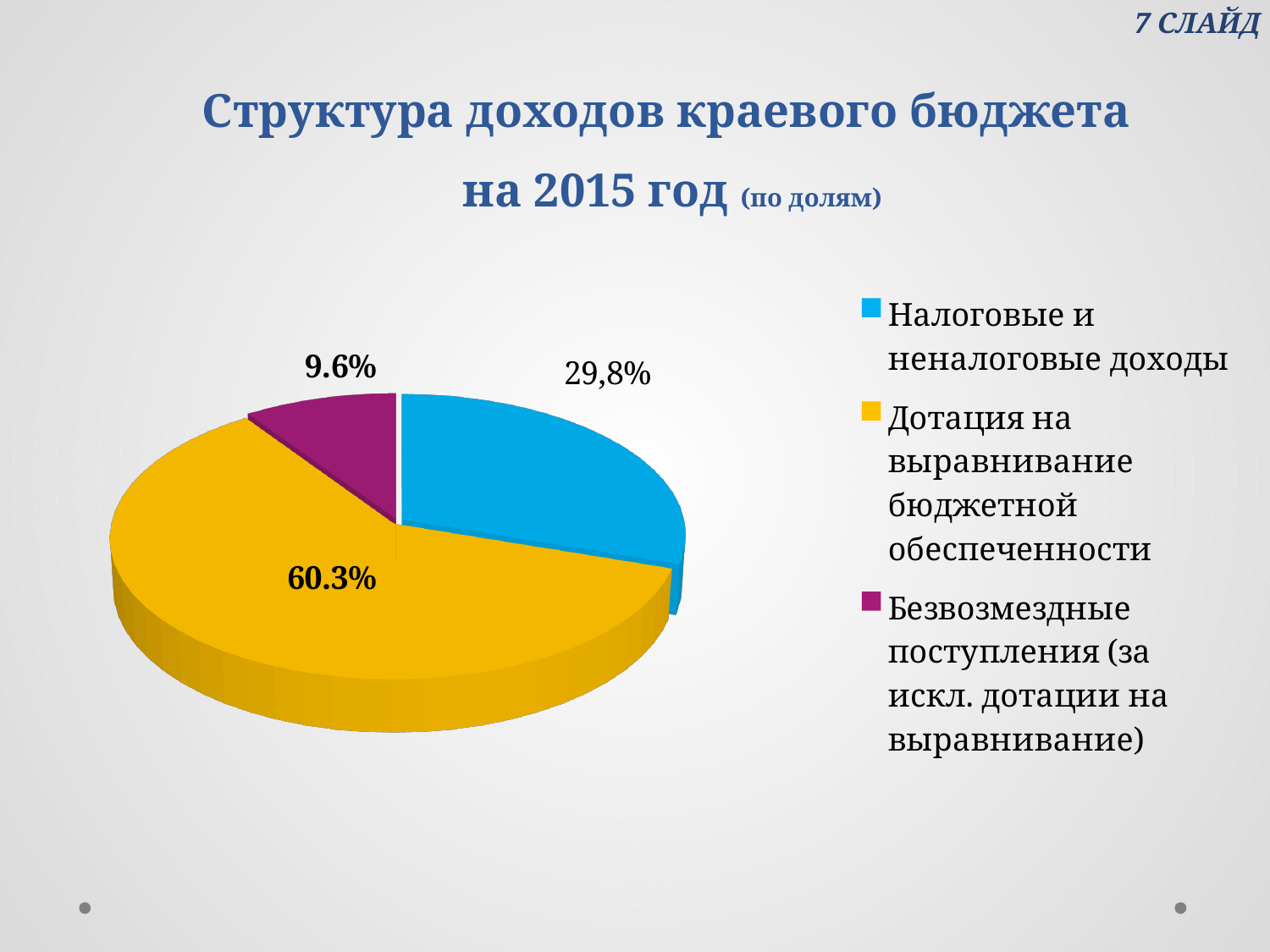
How many entries does the legend list? 3 What share of the pie is labelled for Безвозмездные поступления (за искл. дотации на выравнивание)? 9.6% How many slices does the pie chart have? 3 What type of chart is shown on the slide? Pie chart What colour is the slice for Дотация на выравнивание бюджетной обеспеченности? Yellow What share of the pie is labelled for Дотация на выравнивание бюджетной обеспеченности? 60.3% What share of the pie is labelled for Налоговые и неналоговые доходы? 29,8% Which is larger: the slice for Налоговые и неналоговые доходы or the slice for Безвозмездные поступления? Налоговые и неналоговые доходы By how many percentage points does the Налоговые и неналоговые доходы slice exceed the Безвозмездные поступления slice? 20.2 Which category has the largest slice of the pie? Дотация на выравнивание бюджетной обеспеченности Which category has the smallest slice of the pie? Безвозмездные поступления (за искл. дотации на выравнивание) By how many percentage points does the Дотация на выравнивание бюджетной обеспеченности slice exceed the Налоговые и неналоговые доходы slice? 30.5